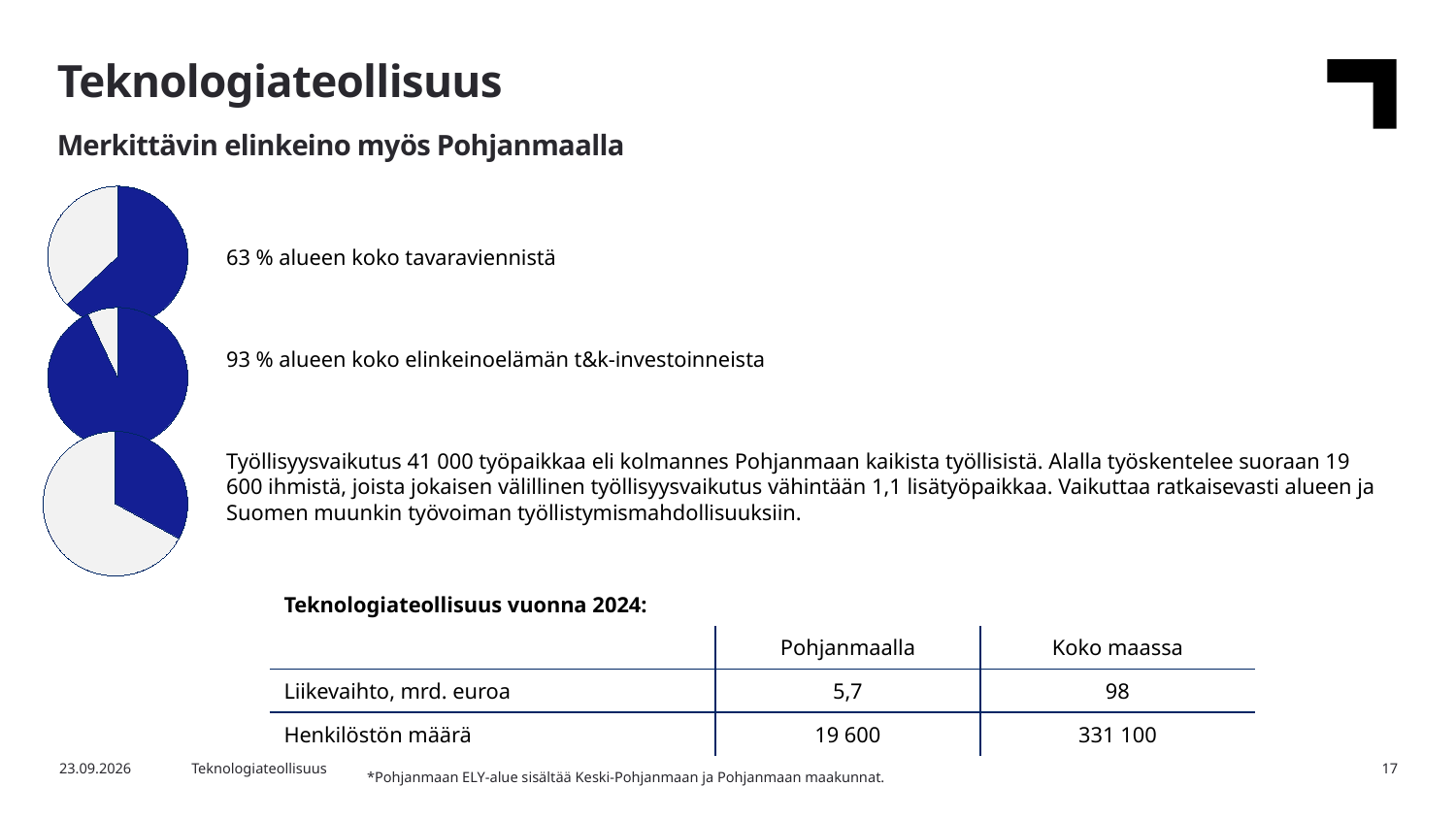
Which of the three pie charts has the smallest blue share? The bottom one (työllisyysvaikutus) Which of the three pie charts has the largest blue share? The middle one (t&k-investoinnit, 93 %) What is the difference in percentage points between the blue share of the middle pie chart (93 %) and the top pie chart (63 %)? 30 percentage points In the middle pie chart (t&k-investoinnit), what share does the blue slice represent? 93 % In the middle pie chart (t&k-investoinnit), is the blue slice greater or less than 75 %? greater What colour is the highlighted slice in each pie chart? Dark blue What does the top pie chart represent according to the text next to it? Alueen koko tavaravienti (the region's total goods exports) Which pie chart has the larger blue slice, the top one (tavaravienti) or the middle one (t&k-investoinnit)? The middle one (t&k-investoinnit) In the top pie chart (tavaravienti), what share does the blue slice represent? 63 % What kind of chart are the three graphics on the left side of the slide? Pie chart How many pie charts are shown on the slide? 3 In the bottom pie chart (työllisyysvaikutus), is the blue slice greater or less than 50 %? less